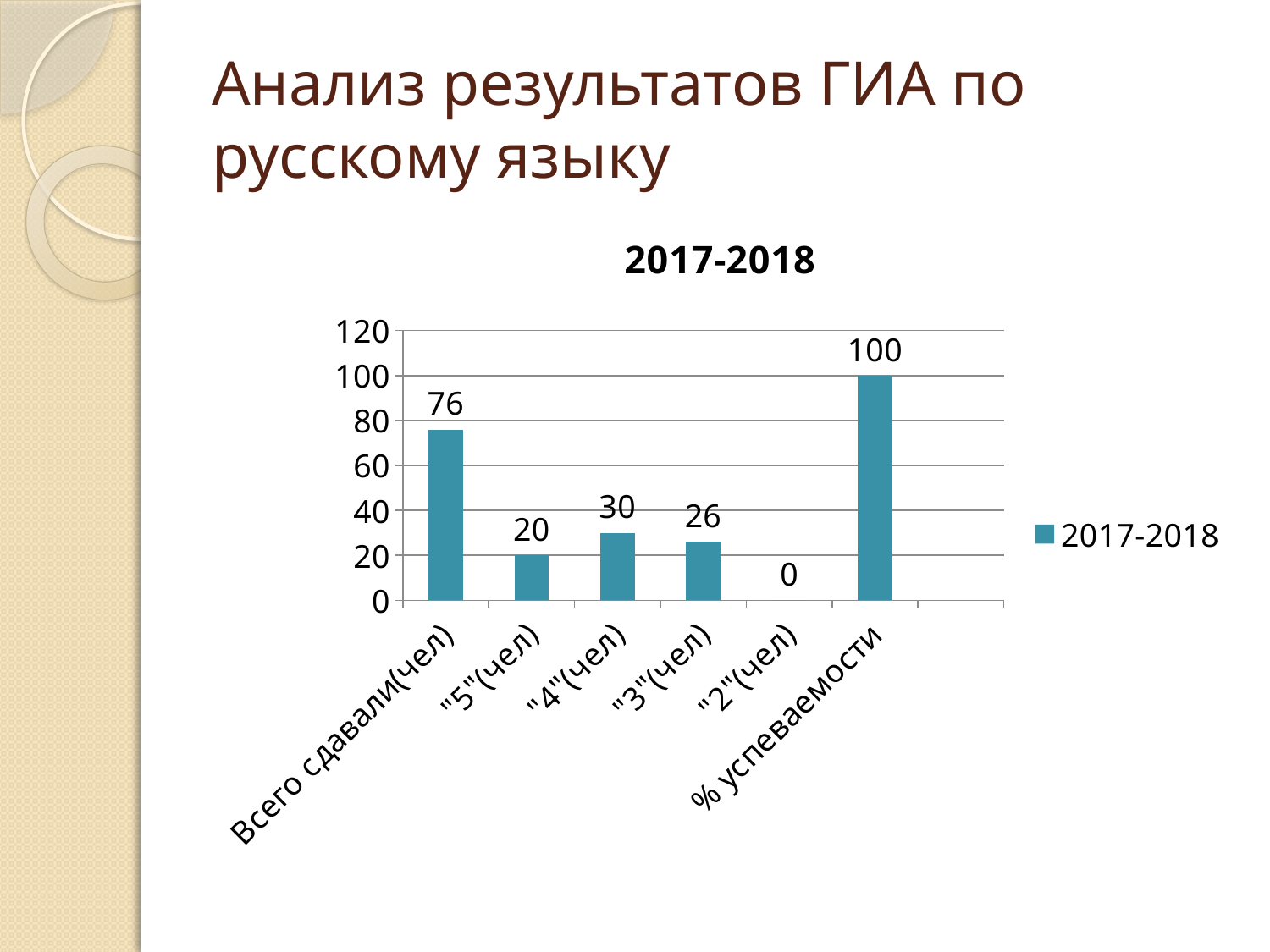
What is the value for "Всего сдавали(чел)"? 76 What is the value for ""4"(чел)"? 30 How many series does the legend list? 1 Which category has the lowest value? "2"(чел) Is the value for "Всего сдавали(чел)" greater or less than 60? greater How many categories are shown on the x axis? 6 Which category has the highest value? % успеваемости Which is larger, the value for ""5"(чел)" or the value for ""3"(чел)"? "3"(чел) What is the difference between the values for ""4"(чел)" and ""3"(чел)"? 4 What is the value for "% успеваемости"? 100 What kind of chart is shown on the slide? bar chart What is the value for ""2"(чел)"? 0